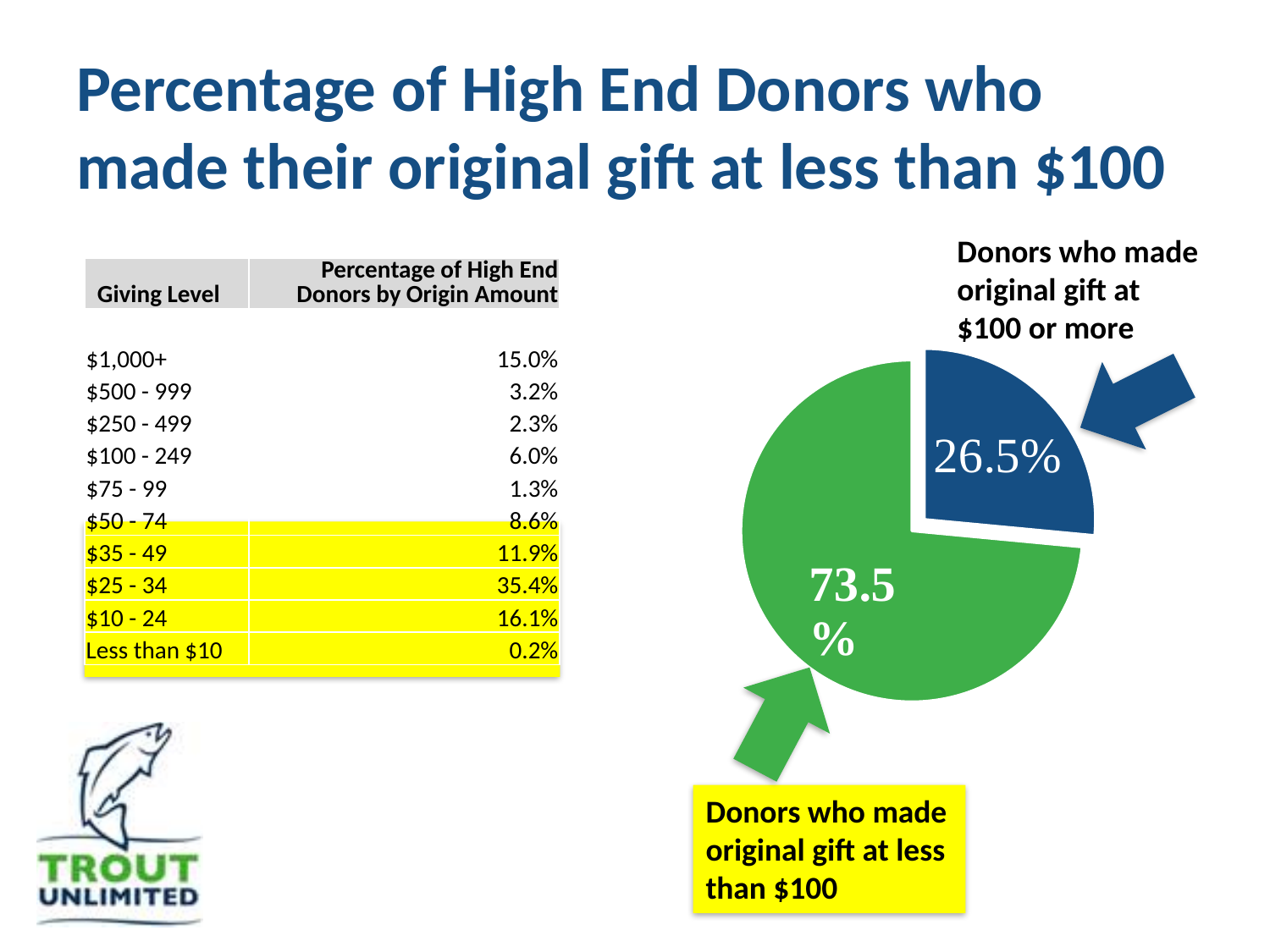
What colour is the slice for donors who made their original gift at $100 or more? blue What colour is the slice for donors who made their original gift at less than $100? green What kind of chart is shown on the slide? pie chart Which is larger: the slice for donors who made their original gift at less than $100 or the slice for those who gave $100 or more? Donors who made original gift at less than $100 How many slices does the pie chart have? 2 What is the difference between the share of donors who gave less than $100 originally and those who gave $100 or more? 47.0% What share of the pie is for donors who made their original gift at $100 or more? 26.5% Which slice of the pie chart is the smallest? Donors who made original gift at $100 or more Which slice of the pie chart is the largest? Donors who made original gift at less than $100 What share of the pie is for donors who made their original gift at less than $100? 73.5%